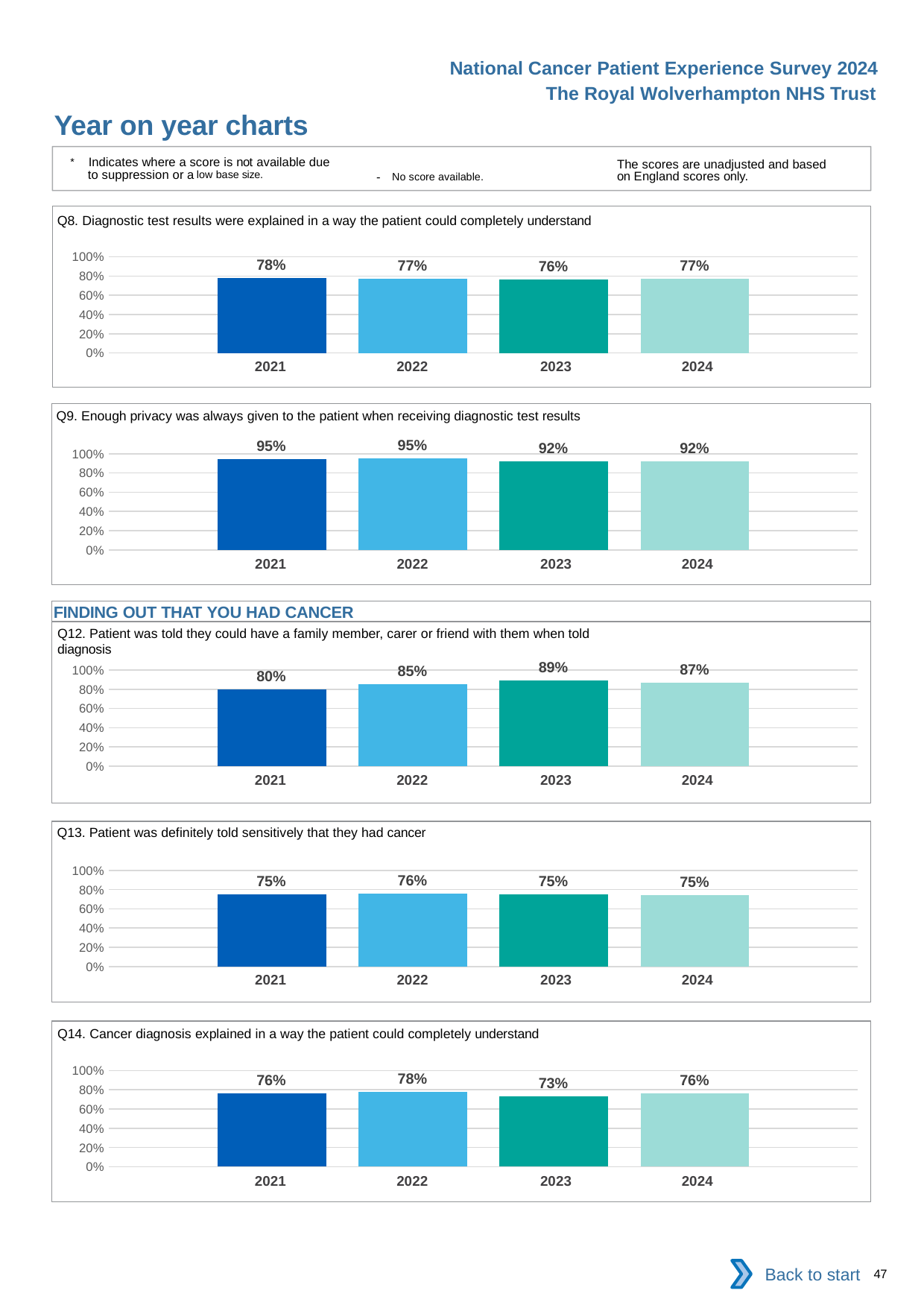
In the Q13 chart (Patient was definitely told sensitively that they had cancer), what is the value for 2022? 76% In the Q8 chart (Diagnostic test results were explained in a way the patient could completely understand), what is the value for 2021? 78% In the Q9 chart (Enough privacy was always given to the patient when receiving diagnostic test results), what is the value for 2024? 92% In the Q12 chart, what is the value for 2022? 85% In the Q9 chart, what is the difference between the 2022 value and the 2023 value? 3% In the Q8 chart, which year has the lowest value? 2023 In the Q14 chart, what is the difference between the 2022 value and the 2023 value? 5% In the Q14 chart (Cancer diagnosis explained in a way the patient could completely understand), what is the value for 2023? 73% In the Q12 chart, is the value for 2021 larger or smaller than the value for 2024? smaller What kind of chart is the Q14 chart? bar chart In the Q13 chart, how many years are plotted? 4 In the Q12 chart (Patient was told they could have a family member, carer or friend with them when told diagnosis), which year has the highest value? 2023